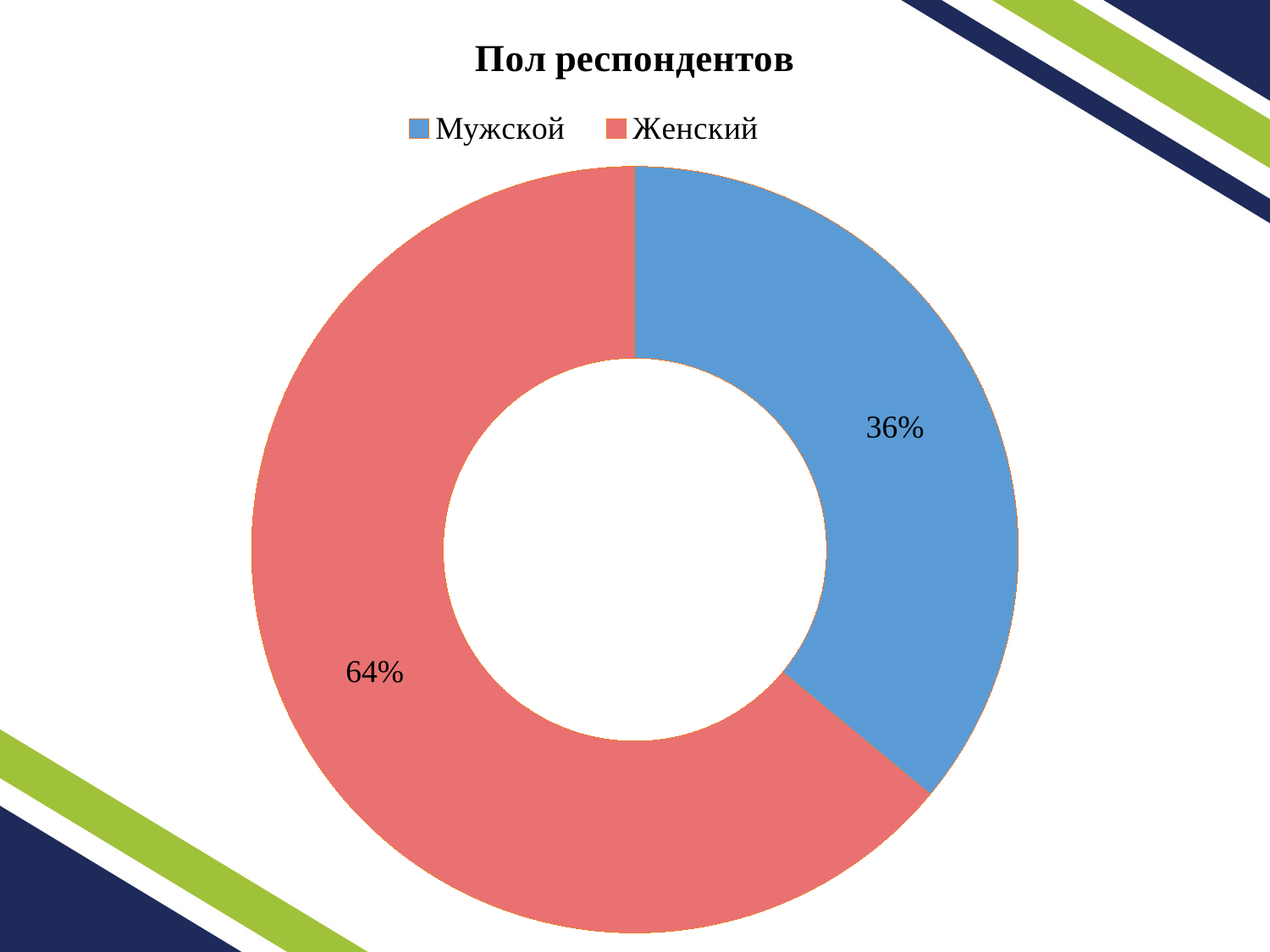
Is the share for Мужской greater or less than 50%? less What share of respondents are Женский (female)? 64% How many entries does the legend list? 2 What is the title of the chart? Пол респондентов How many categories does the chart show? 2 Which category has the smallest share of respondents? Мужской Which category has the largest share of respondents? Женский What share of respondents are Мужской (male)? 36% What kind of chart is shown on the slide? Doughnut (pie) chart Which is larger, the share for Мужской or for Женский? Женский What is the difference in percentage points between the Женский and Мужской shares? 28 What colour represents Мужской in the chart? Blue